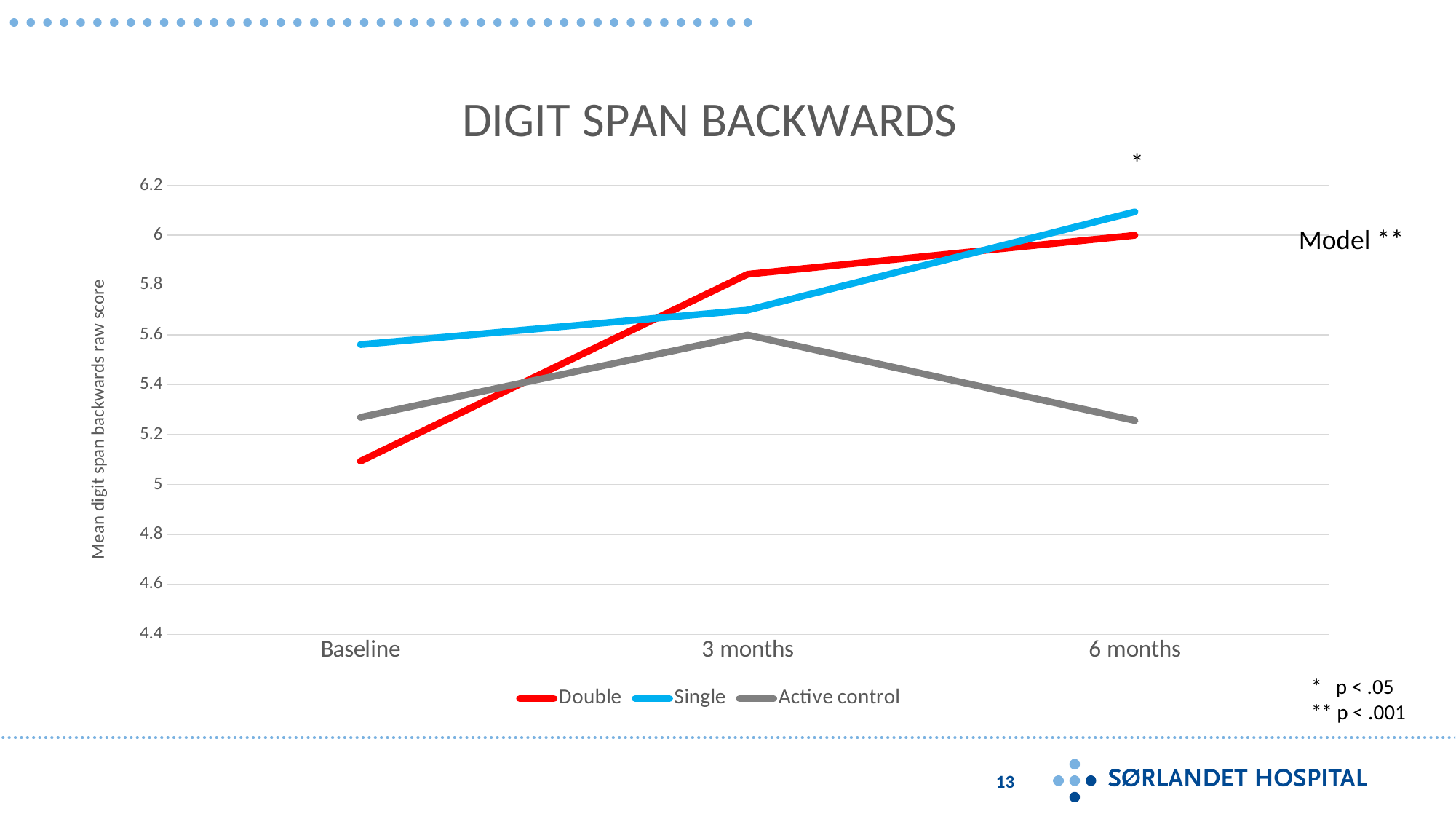
What is the title of the chart? DIGIT SPAN BACKWARDS Which series has the highest value at 6 months? Single What kind of chart is shown on the slide? line chart Does the Double series rise or fall from Baseline to 6 months? rises Which series has the lowest value at Baseline? Double How many series does the legend list? 3 At 6 months, which series has the higher value, Single or Active control? Single Is the value for Double at Baseline greater or less than 5.2? less How many time points are shown on the x axis? 3 At Baseline, which series has the higher value, Single or Double? Single Is the value for Single at 6 months greater or less than 6? greater Is the value for Active control at 6 months greater or less than 5.4? less